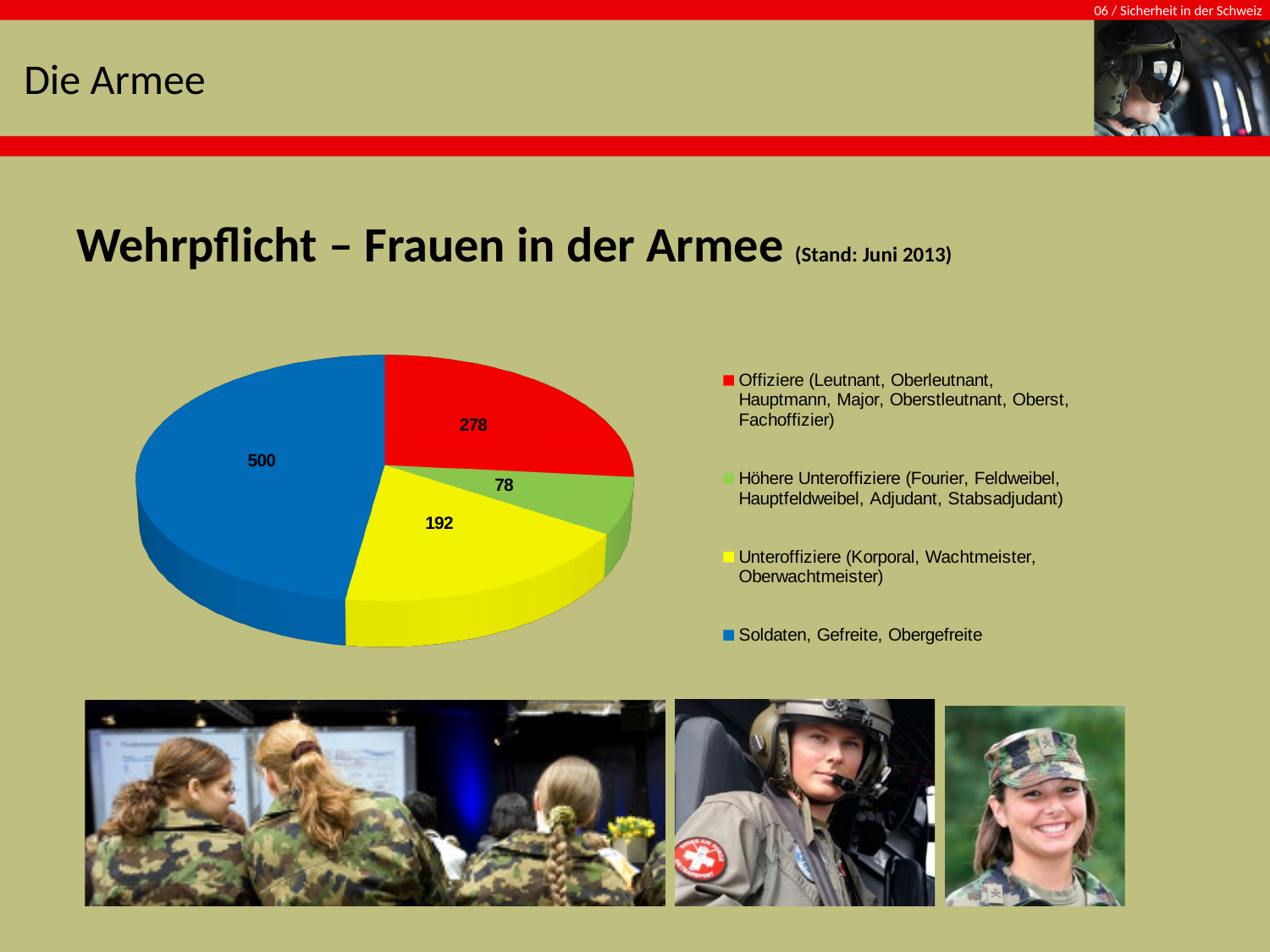
Which category has the smallest slice of the pie? Höhere Unteroffiziere (Fourier, Feldweibel, Hauptfeldweibel, Adjudant, Stabsadjudant) What is the value for Unteroffiziere (Korporal, Wachtmeister, Oberwachtmeister)? 192 Which category has the largest slice of the pie? Soldaten, Gefreite, Obergefreite What kind of chart is shown on the slide? Pie chart Which is larger, the value for Unteroffiziere (Korporal, Wachtmeister, Oberwachtmeister) or the value for Höhere Unteroffiziere? Unteroffiziere (Korporal, Wachtmeister, Oberwachtmeister) What is the value for Offiziere (Leutnant, Oberleutnant, Hauptmann, Major, Oberstleutnant, Oberst, Fachoffizier)? 278 What colour is the slice for Soldaten, Gefreite, Obergefreite? Blue What is the total of all four slices in the pie chart? 1048 What is the value for Höhere Unteroffiziere (Fourier, Feldweibel, Hauptfeldweibel, Adjudant, Stabsadjudant)? 78 How many slices does the pie chart have? 4 What is the value for Soldaten, Gefreite, Obergefreite? 500 What is the difference between the value for Soldaten, Gefreite, Obergefreite and the value for Offiziere? 222